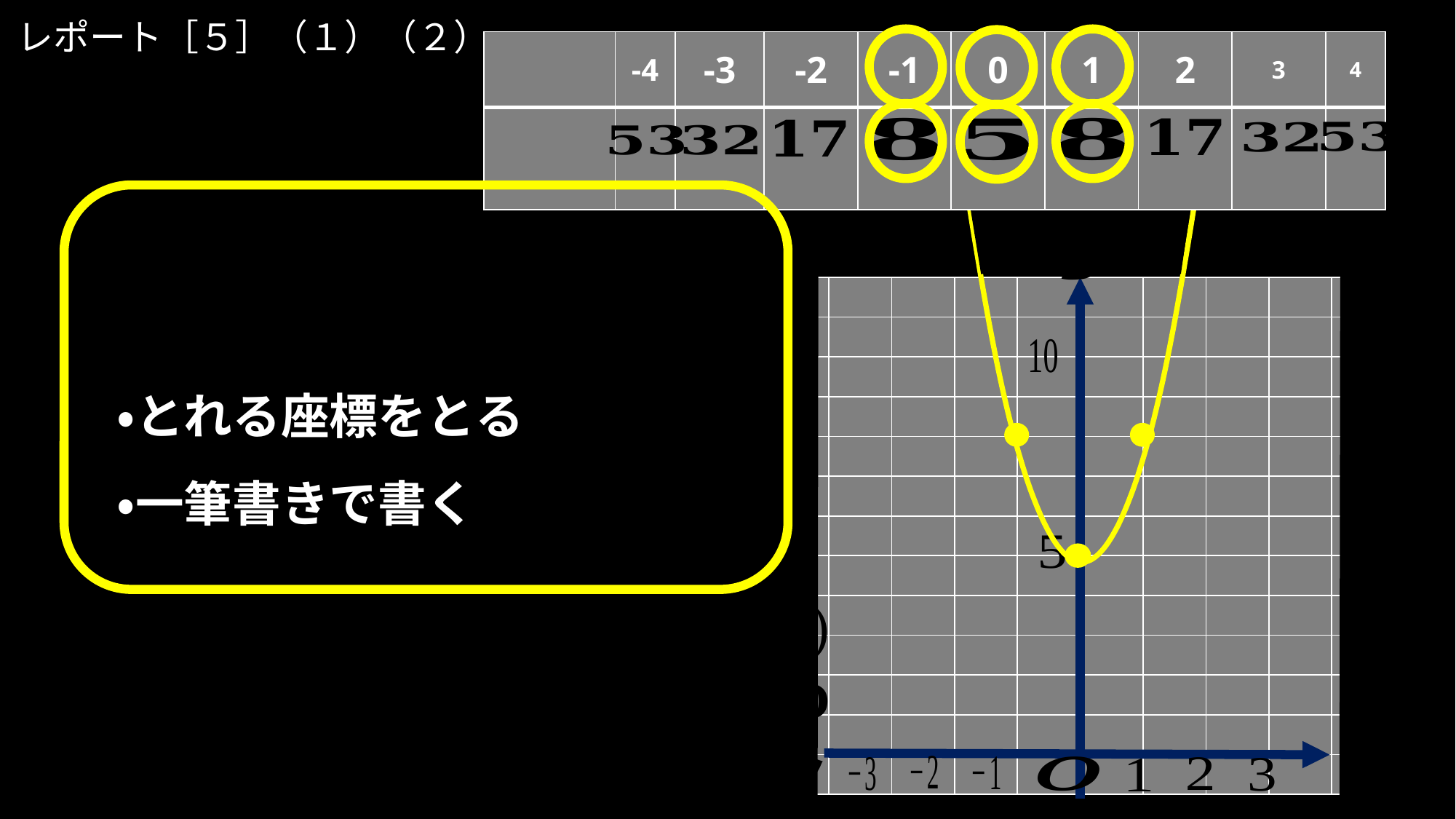
In the table, do the values rise or fall as x goes from 0 to 4? rise In the table, what is the value listed under x = 2? 17 How many x values are listed in the table? 9 How many points are marked with dots on the graph? 3 On the graph, is the y value of the plotted point at x = 1 greater or less than 5? greater In the table, which is larger: the value at x = -2 or the value at x = 1? x = -2 In the table, what is the value listed under x = -1? 8 What shape does the yellow curve on the graph have? a parabola (U-shaped curve) In the table, what is the value listed under x = -3? 32 In the table, which x value has the smallest listed value? 0 In the table, what is the difference between the values at x = 2 and x = 1? 9 In the table, what is the value listed under x = 0? 5